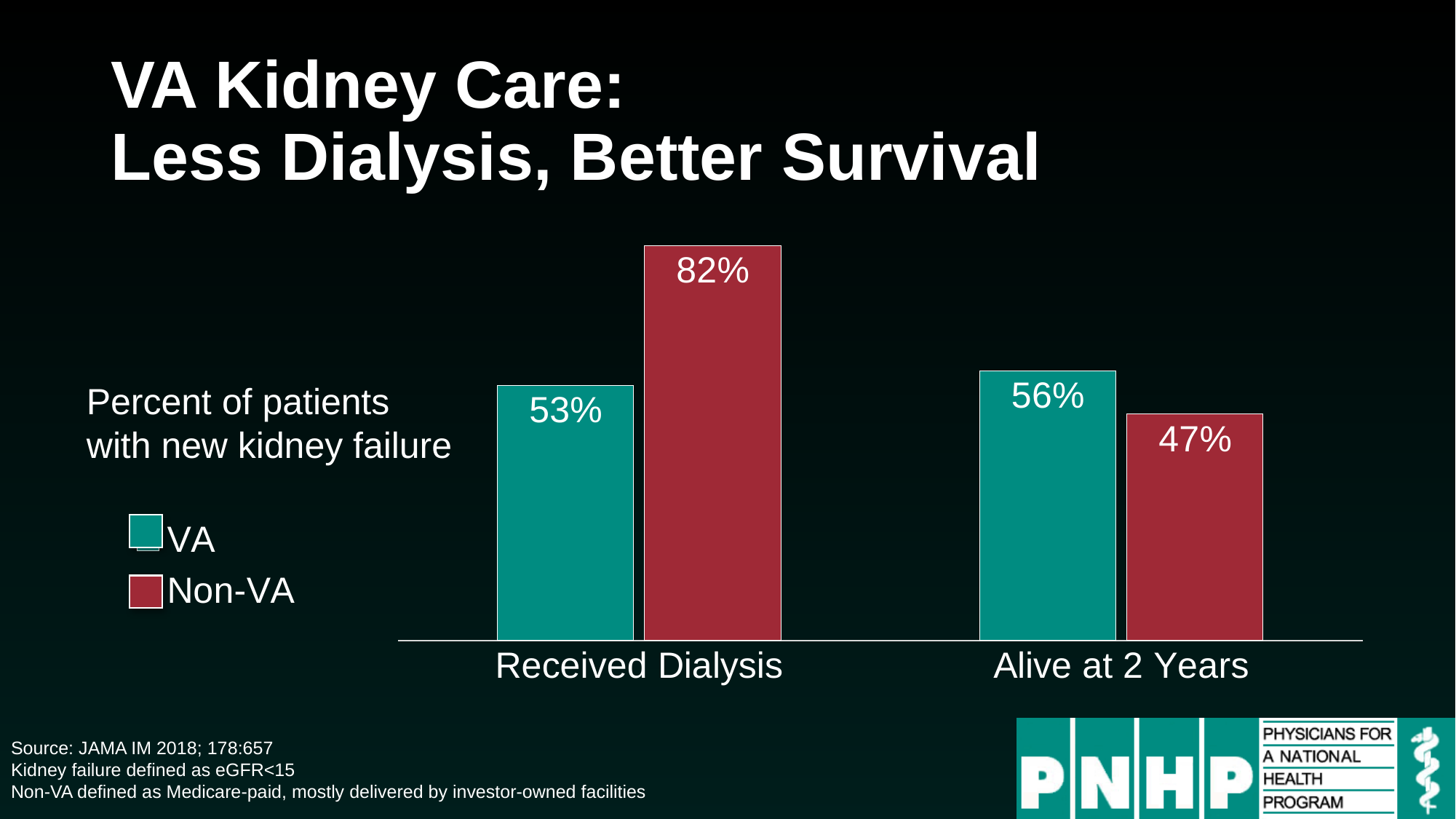
What is the difference between the VA and Non-VA percentages for Alive at 2 Years? 9% What is the difference between the Non-VA and VA percentages for Received Dialysis? 29% What percentage of VA patients received dialysis? 53% What percentage of Non-VA patients were alive at 2 years? 47% Which bar in the chart has the highest value? Non-VA, Received Dialysis What percentage of Non-VA patients received dialysis? 82% How many categories are shown on the x axis of the chart? 2 What kind of chart is shown on the slide? Bar chart What percentage of VA patients were alive at 2 years? 56% How many series does the legend list? 2 For Alive at 2 Years, which group has the larger value, VA or Non-VA? VA Which bar in the chart has the lowest value? Non-VA, Alive at 2 Years